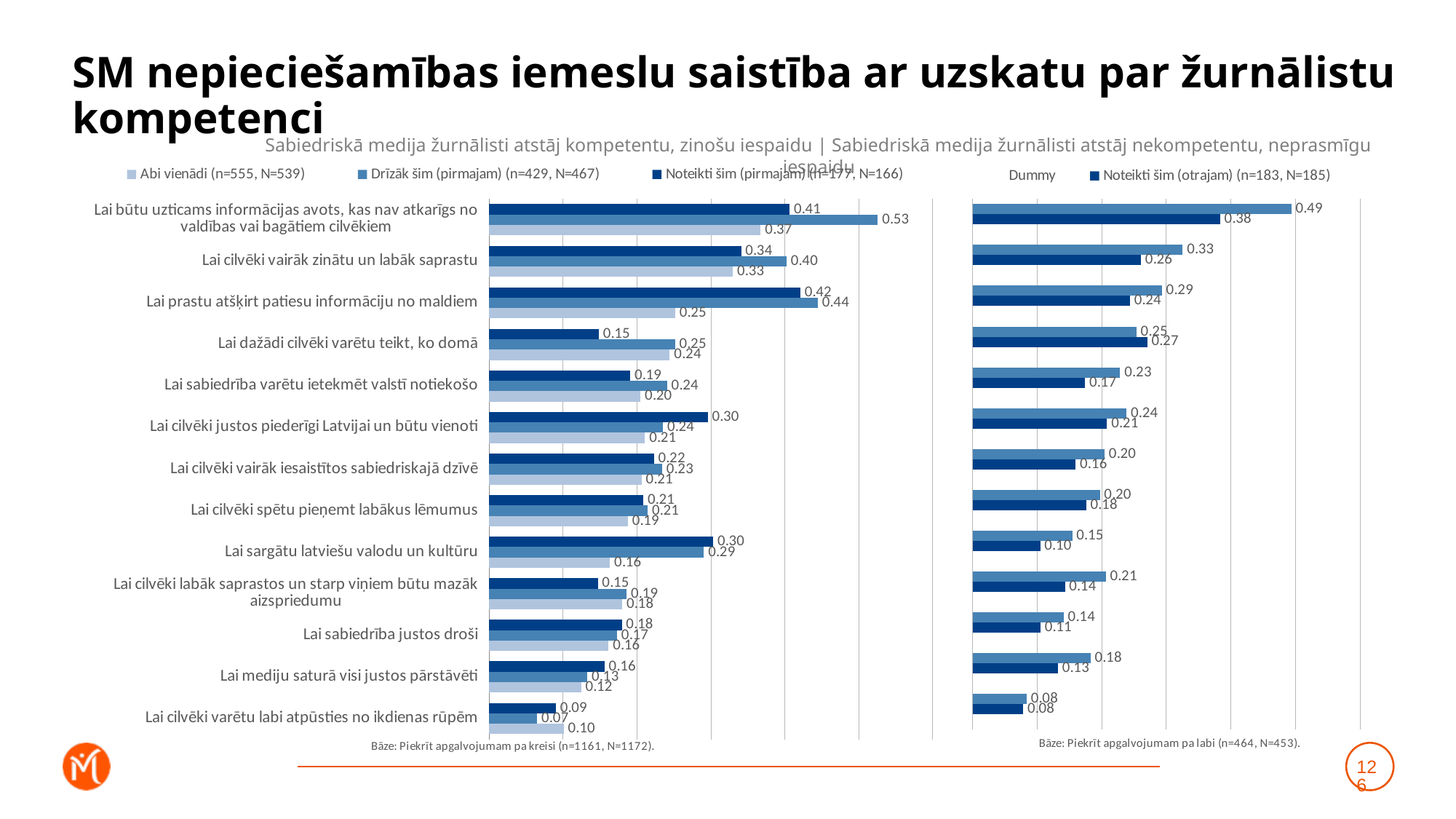
How many series does the legend of the left chart list? 3 In the left chart, what is the Abi vienādi value for "Lai prastu atšķirt patiesu informāciju no maldiem"? 0.25 What type of chart is used on this slide? Bar chart In the right chart, what value do both bars show for "Lai cilvēki varētu labi atpūsties no ikdienas rūpēm"? 0.08 In the right chart, what is the highest value shown, and for which category? 0.49, Lai būtu uzticams informācijas avots, kas nav atkarīgs no valdības vai bagātiem cilvēkiem In the left chart, what is the difference between the Drīzāk šim (pirmajam) and Abi vienādi values for "Lai būtu uzticams informācijas avots, kas nav atkarīgs no valdības vai bagātiem cilvēkiem"? 0.16 In the left chart, which category has the lowest Abi vienādi value? Lai cilvēki varētu labi atpūsties no ikdienas rūpēm In the left chart, what is the Drīzāk šim (pirmajam) value for "Lai būtu uzticams informācijas avots, kas nav atkarīgs no valdības vai bagātiem cilvēkiem"? 0.53 In the left chart, which category has the highest Drīzāk šim (pirmajam) value? Lai būtu uzticams informācijas avots, kas nav atkarīgs no valdības vai bagātiem cilvēkiem How many categories are listed in the left chart? 13 In the left chart, what is the Noteikti šim (pirmajam) value for "Lai sargātu latviešu valodu un kultūru"? 0.30 In the left chart, for "Lai dažādi cilvēki varētu teikt, ko domā", which is larger: the Noteikti šim (pirmajam) value or the Drīzāk šim (pirmajam) value? Drīzāk šim (pirmajam)